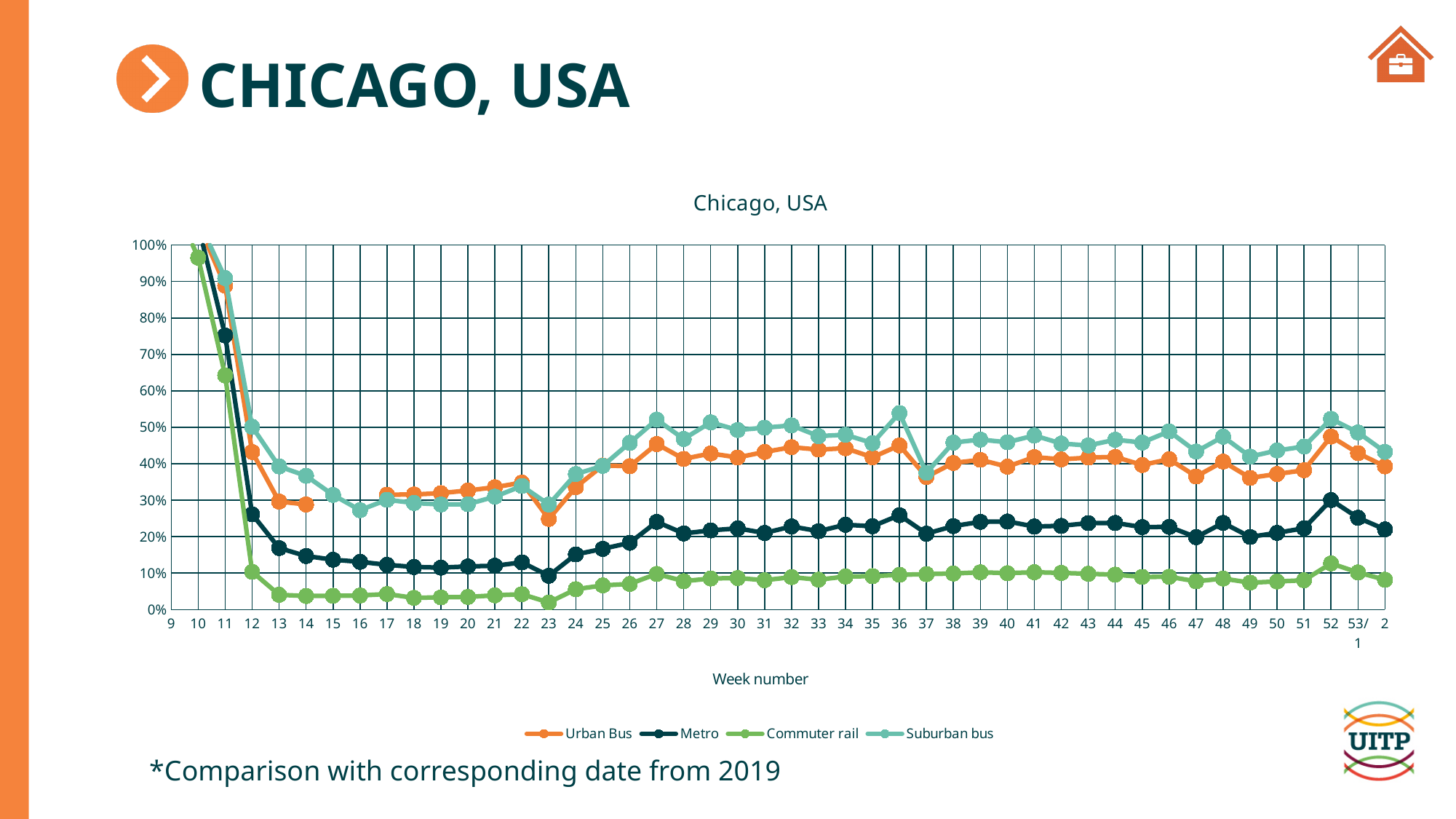
Is the value for Suburban bus at week 36 greater or less than 50%? greater What kind of chart is shown on the slide? line chart Is the value for Metro at week 27 greater or less than 30%? less At week 13, which is higher: Urban Bus or Metro? Urban Bus Is the value for Commuter rail at week 16 greater or less than 10%? less How many series does the legend list? 4 Which series has the highest value at week 27? Suburban bus What is the title of the chart? Chicago, USA Does the Commuter rail series rise or fall from week 10 to week 13? fall Which series has the lowest value at week 40? Commuter rail What is the label of the x axis? Week number